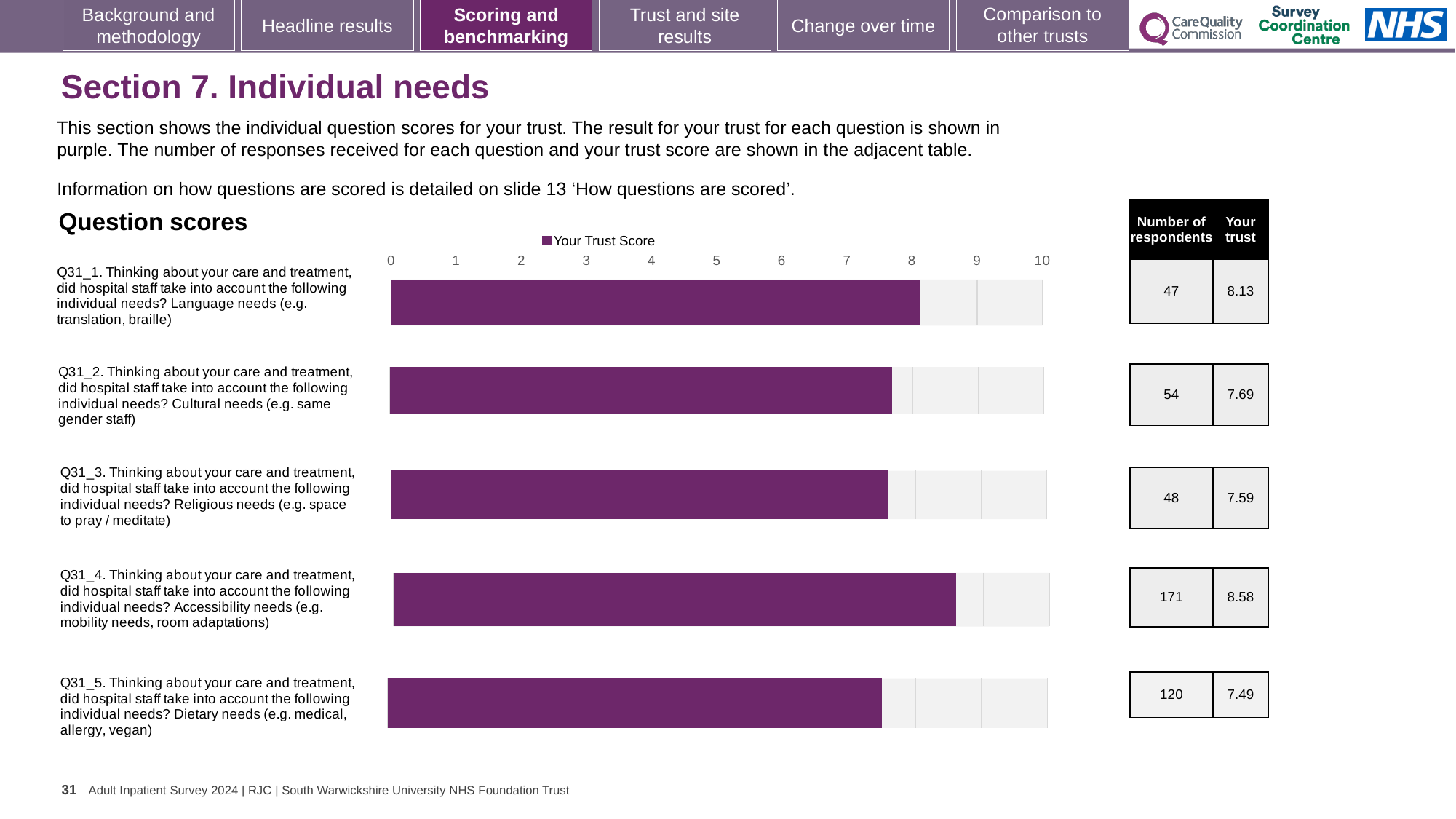
Which question has the highest trust score? Q31_4 (Accessibility needs) What is the name of the series shown in the chart legend? Your Trust Score How many questions are plotted in the chart? 5 Is the trust score for Q31_3 (Religious needs) greater or less than 8? less What type of chart is used to show the question scores? bar chart Which question has the lowest trust score? Q31_5 (Dietary needs) What is the trust score for Q31_5 (Dietary needs)? 7.49 How many respondents answered Q31_4 (Accessibility needs)? 171 What is the trust score for Q31_4 (Accessibility needs)? 8.58 Which has a higher trust score, Q31_1 (Language needs) or Q31_2 (Cultural needs)? Q31_1 (Language needs) What is the difference between the trust scores for Q31_4 (Accessibility needs) and Q31_5 (Dietary needs)? 1.09 What is the trust score for Q31_1 (Language needs)? 8.13